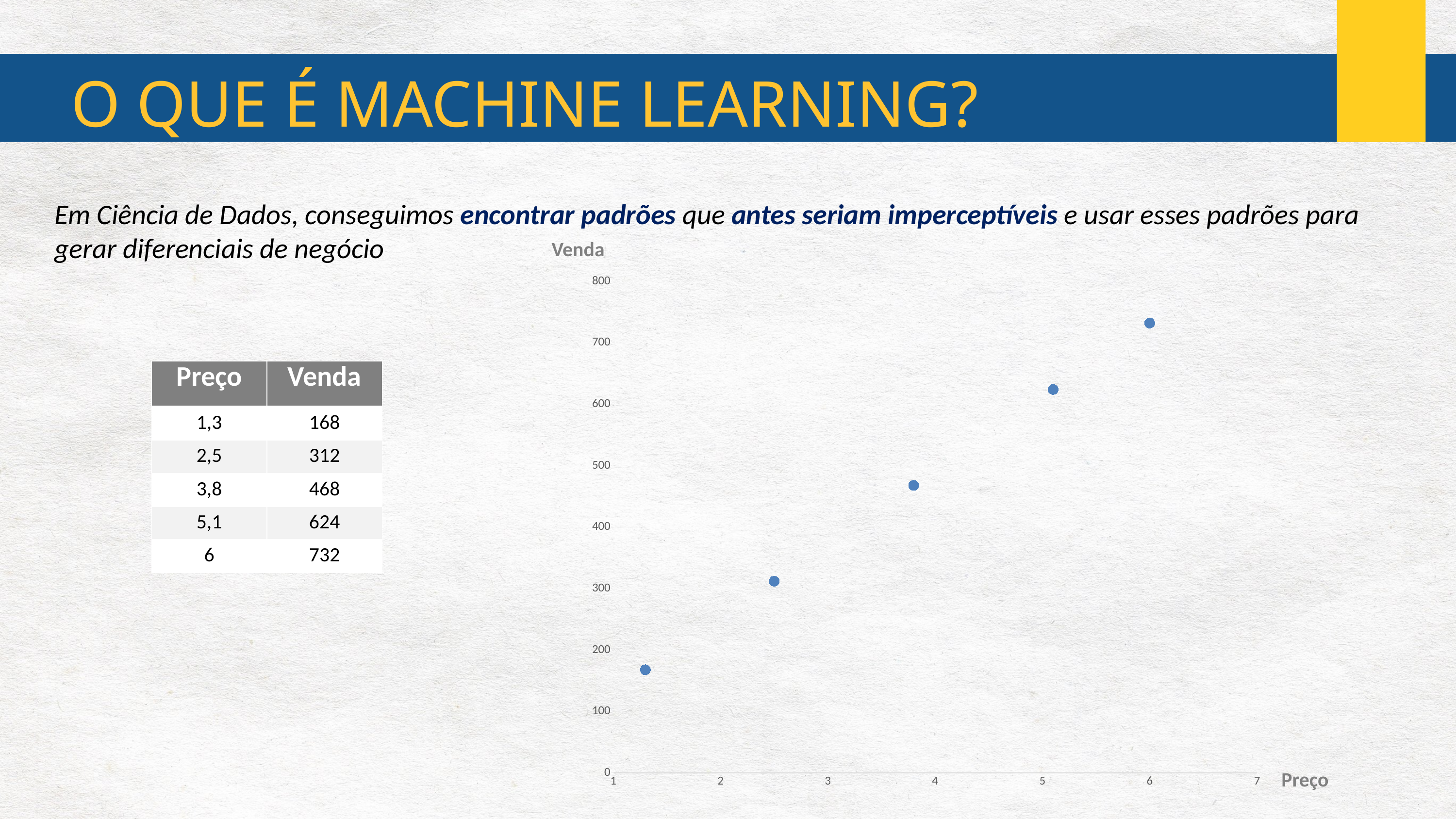
What kind of chart is shown on the slide? scatter chart Is the Venda value for the point at Preço 3,8 greater or less than 500? less Which has the larger Venda value: the point at Preço 5,1 or the point at Preço 3,8? Preço 5,1 Do the Venda values rise or fall as Preço increases along the x axis? rise Using the values in the table, what is the difference between the Venda at Preço 6 and the Venda at Preço 1,3? 564 What is the label of the vertical axis of the chart? Venda According to the table on the slide, what is the Venda value for Preço 2,5? 312 At which Preço is the Venda value lowest? 1,3 How many data points are plotted in the chart? 5 At which Preço is the Venda value highest? 6 Is the Venda value for the point at Preço 1,3 greater or less than 200? less Is the Venda value for the point at Preço 6 greater or less than 700? greater